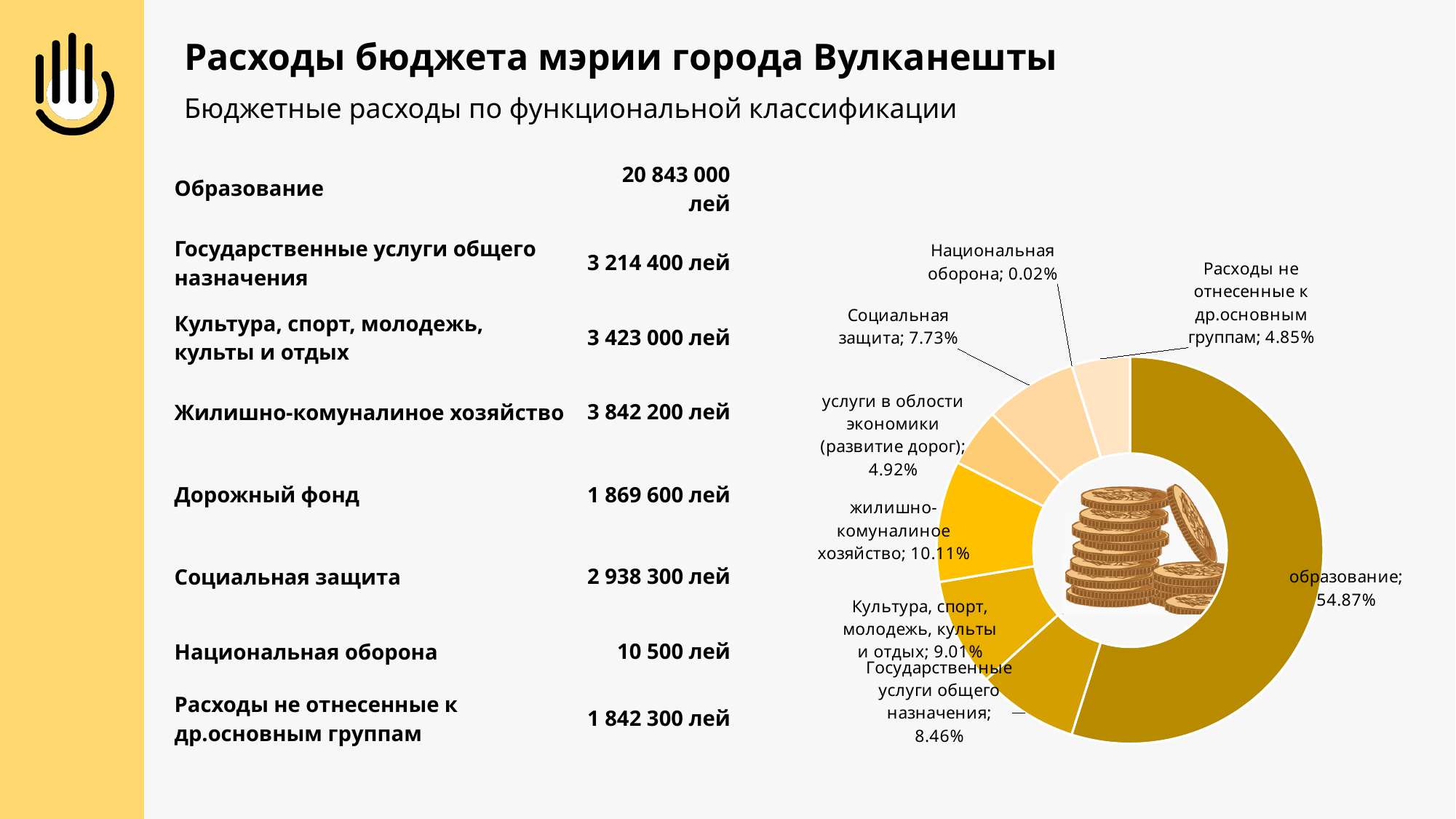
Which slice is larger: Культура, спорт, молодежь, культы и отдых or Государственные услуги общего назначения? Культура, спорт, молодежь, культы и отдых What kind of chart is shown on the slide? Doughnut (pie) chart What percentage is shown for жилишно-комуналиное хозяйство in the chart? 10.11% What percentage is shown for Социальная защита in the chart? 7.73% Which category has the largest slice in the chart? образование What is the difference in percentage points between услуги в облости экономики (развитие дорог) and Расходы не отнесенные к др.основным группам? 0.07 What is the difference in percentage points between the образование slice and the жилишно-комуналиное хозяйство slice? 44.76 What share of the doughnut chart is labelled for образование? 54.87% What percentage is shown for Национальная оборона in the chart? 0.02% What is the subtitle shown above the chart on the slide? Бюджетные расходы по функциональной классификации Which category has the smallest slice in the chart? Национальная оборона How many slices does the doughnut chart have? 8